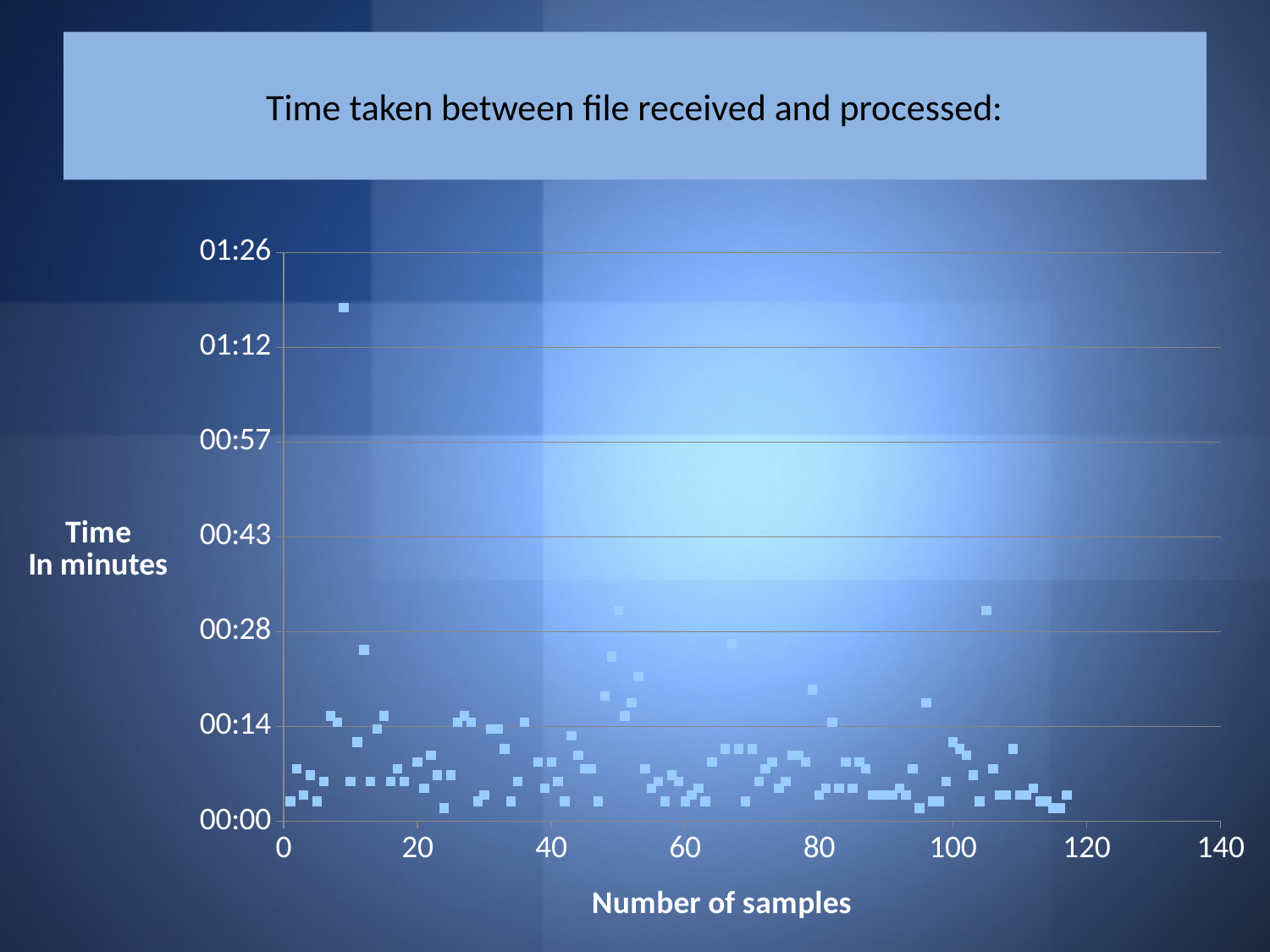
Is the highest plotted point on the chart greater or less than 00:57? greater Is the highest plotted point on the chart greater or less than 01:26? less What is the label on the x axis of the chart? Number of samples Is the lowest plotted point on the chart greater or less than 00:14? less What is the title of the chart? Time taken between file received and processed: What kind of chart is shown on the slide? scatter chart